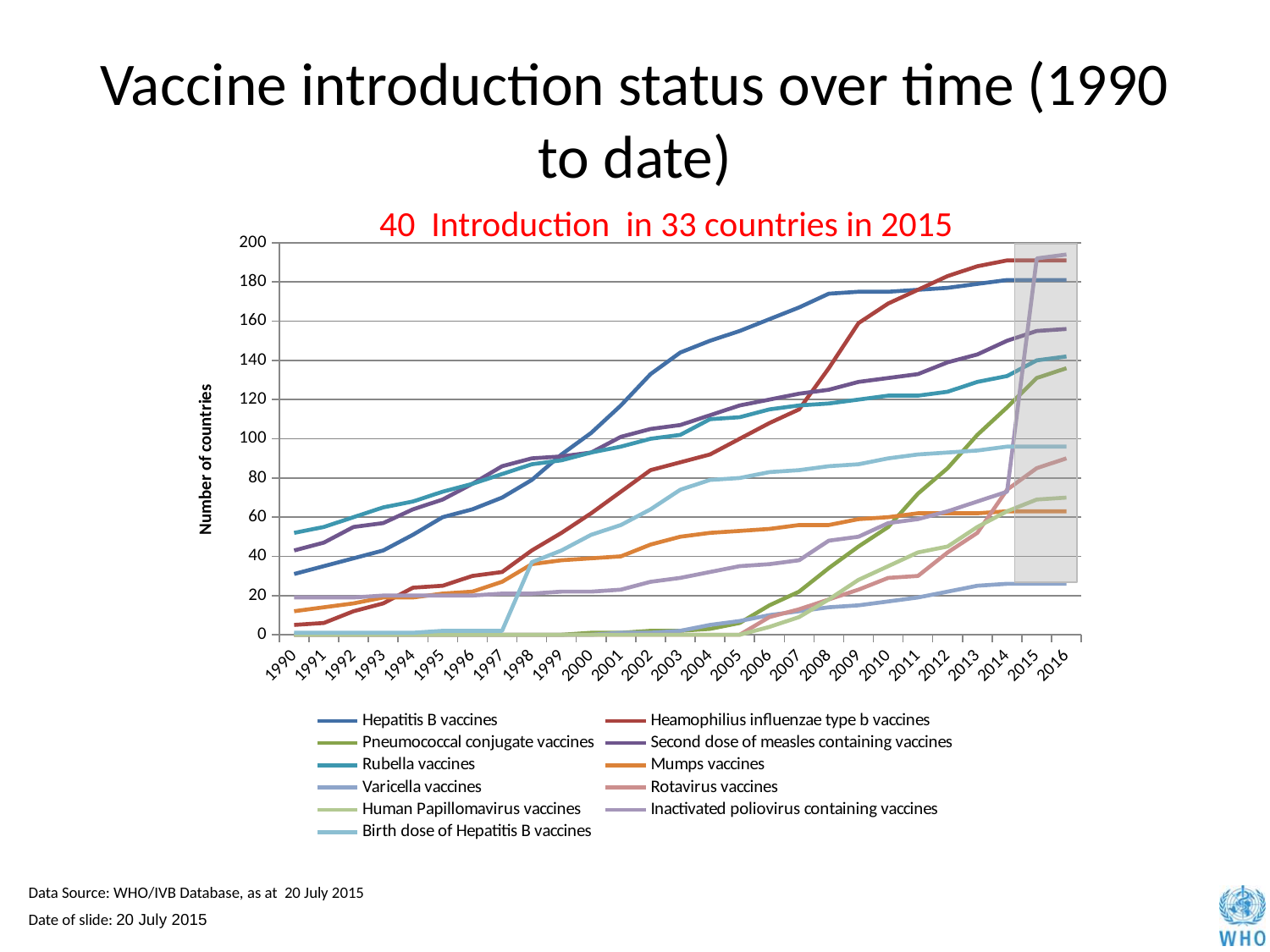
How many years are plotted along the x axis? 27 How many series does the legend list? 11 Is the value for Pneumococcal conjugate vaccines in 2016 greater or less than 120? greater Is the value for Human Papillomavirus vaccines in 2016 greater or less than 80? less Is the value for Varicella vaccines in 2016 greater or less than 40? less What is the label on the y axis of the chart? Number of countries What kind of chart is shown on the slide? line chart Which series has the lowest value in 2016? Varicella vaccines Which series has the highest value in 1990? Rubella vaccines Does the number of countries for Hepatitis B vaccines rise or fall from 1990 to 2016? rise In 2016, which is larger: the value for Hepatitis B vaccines or the value for Mumps vaccines? Hepatitis B vaccines